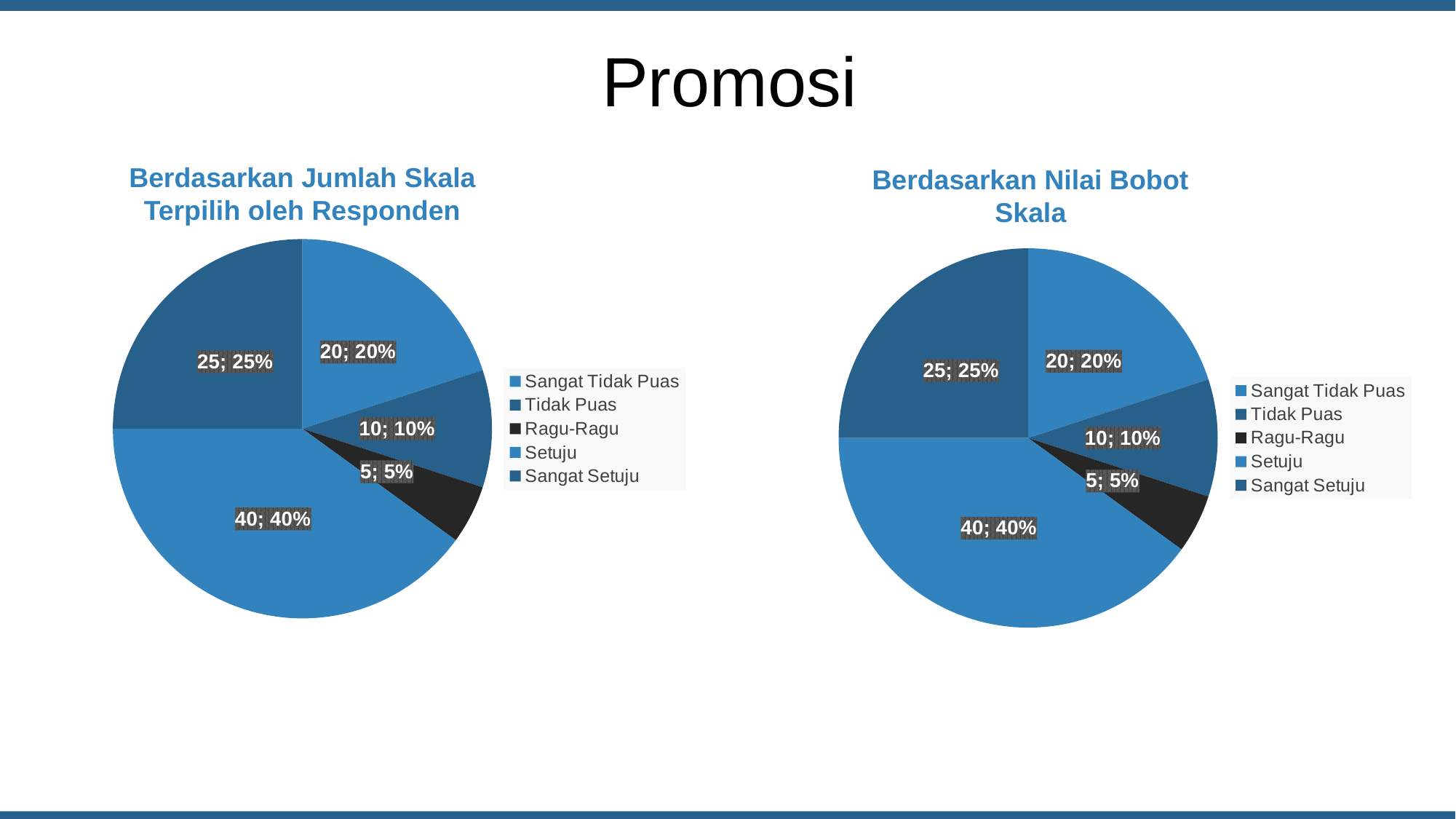
In the right chart, which category has the smallest slice? Ragu-Ragu In the chart titled "Berdasarkan Nilai Bobot Skala", what is the value shown for Sangat Setuju? 25 In the chart titled "Berdasarkan Jumlah Skala Terpilih oleh Responden", what is the difference between the values for Setuju and Sangat Setuju? 15 What type of chart is the chart titled "Berdasarkan Nilai Bobot Skala"? Pie chart In the chart titled "Berdasarkan Jumlah Skala Terpilih oleh Responden", what share of the pie does Setuju take? 40% How many entries does the legend of the chart titled "Berdasarkan Nilai Bobot Skala" list? 5 In the right chart, which is larger: Sangat Tidak Puas or Tidak Puas? Sangat Tidak Puas In the right chart, what is the value shown for Tidak Puas? 10 How many slices does the left pie chart have? 5 In the left chart, what share of the pie does Ragu-Ragu take? 5% In the left chart, what colour is the Ragu-Ragu slice? Black In the left chart, which category has the largest slice? Setuju